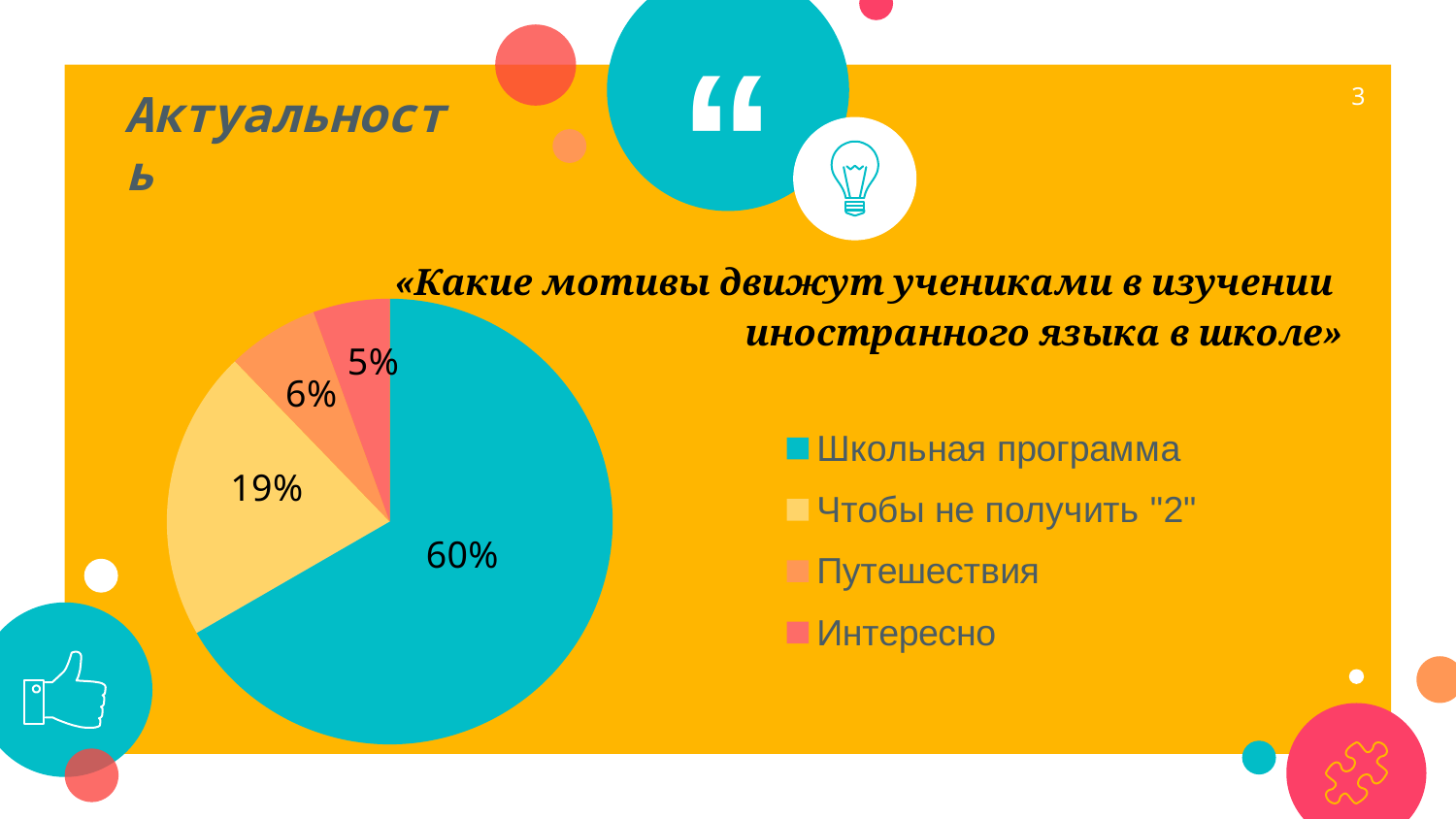
What is the value shown for "Интересно"? 5% What is the title of the chart? «Какие мотивы движут учениками в изучении иностранного языка в школе» Which category has the smallest slice of the pie? Интересно Which category has the largest slice of the pie? Школьная программа How many categories does the pie chart have? 4 What is the value shown for "Путешествия"? 6% What is the difference between the values for "Школьная программа" and "Чтобы не получить "2""? 41% What kind of chart is shown on the slide? Pie chart What colour is the slice for "Чтобы не получить "2""? Yellow What is the value shown for "Чтобы не получить "2""? 19% Which is larger, the value for "Путешествия" or the value for "Интересно"? Путешествия What share of the pie does "Школьная программа" take? 60%